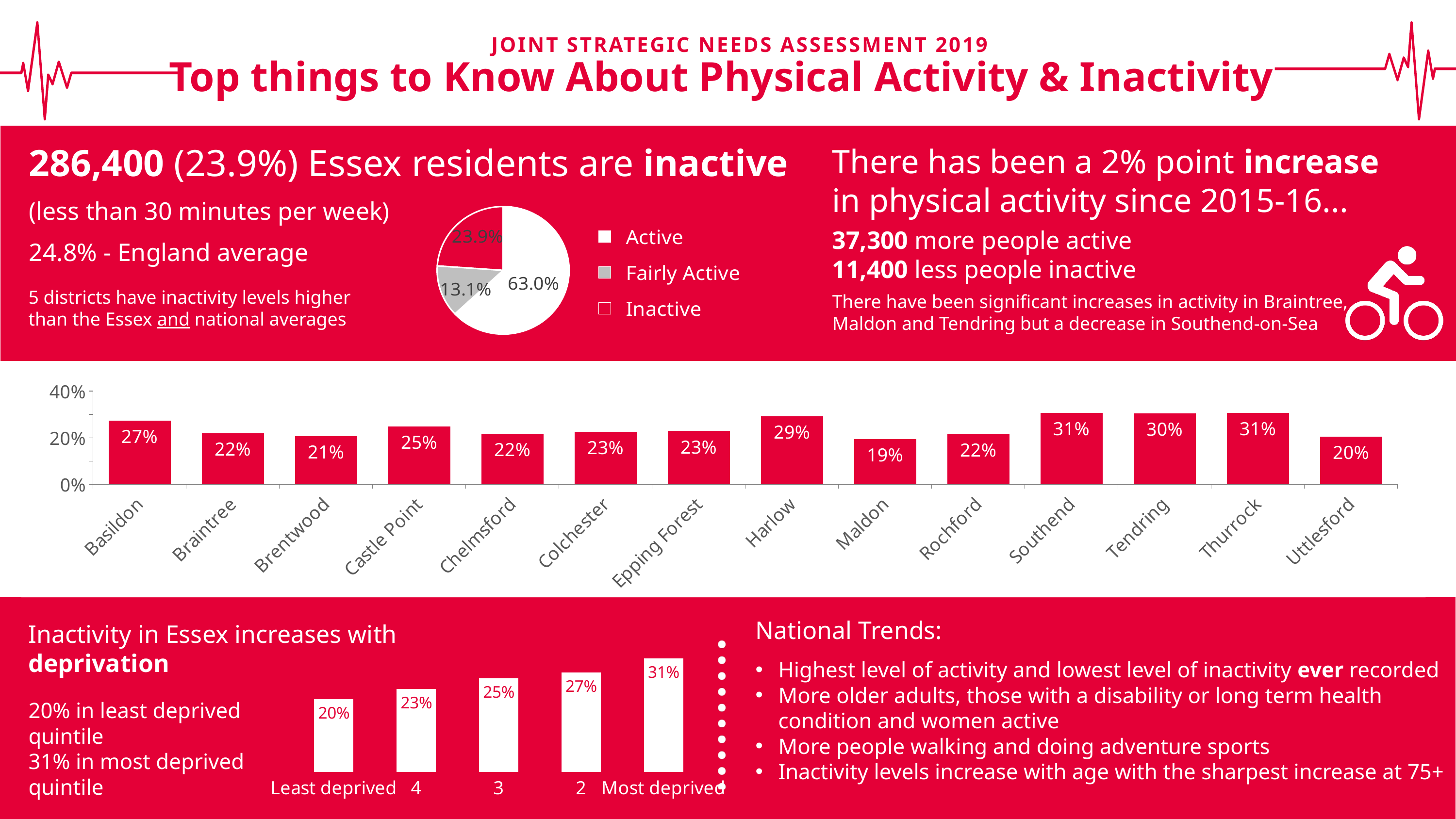
What type of chart is the district chart in the middle of the slide? Bar chart In the deprivation bar chart at the bottom left of the slide, what is the value for the Most deprived quintile? 31% In the district bar chart in the middle of the slide, what is the value for Harlow? 29% In the pie chart at the top of the slide, what percentage is shown for Active? 63.0% In the pie chart at the top of the slide, what percentage is shown for Fairly Active? 13.1% How many entries does the legend of the pie chart at the top of the slide list? 3 In the district bar chart in the middle of the slide, what is the difference between Southend and Uttlesford? 11% In the deprivation bar chart at the bottom left of the slide, do the values rise or fall from Least deprived to Most deprived? Rise In the district bar chart in the middle of the slide, which district has the lowest value? Maldon In the district bar chart in the middle of the slide, how many districts are shown? 14 In the pie chart at the top of the slide, what share is labelled for the Inactive slice? 23.9% In the district bar chart in the middle of the slide, which is larger, Castle Point or Brentwood? Castle Point